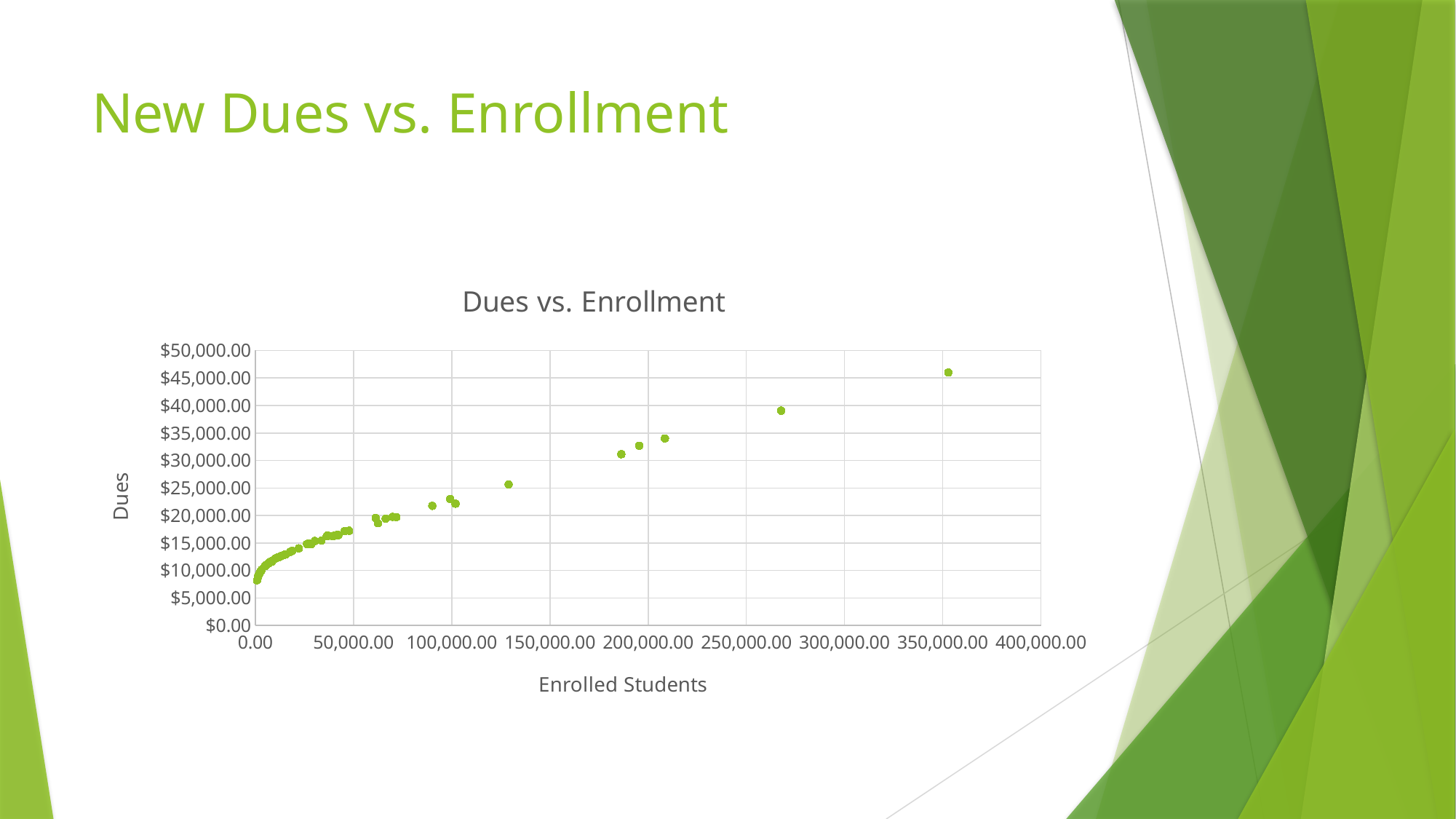
What kind of chart is shown on the slide? Scatter chart What is the label of the horizontal axis? Enrolled Students Is the lowest dues value plotted greater or less than $10,000.00? less What is the title of the chart? Dues vs. Enrollment As the number of enrolled students increases, do the dues rise or fall? Rise Which point has higher dues: the one near 270,000 enrolled students or the one near 130,000 enrolled students? The one near 270,000 enrolled students Is the dues value for the point near 270,000 enrolled students greater or less than $35,000.00? greater Is the dues value for the point near 200,000 enrolled students greater or less than $30,000.00? greater Does the point with the highest dues also have the highest enrollment? Yes